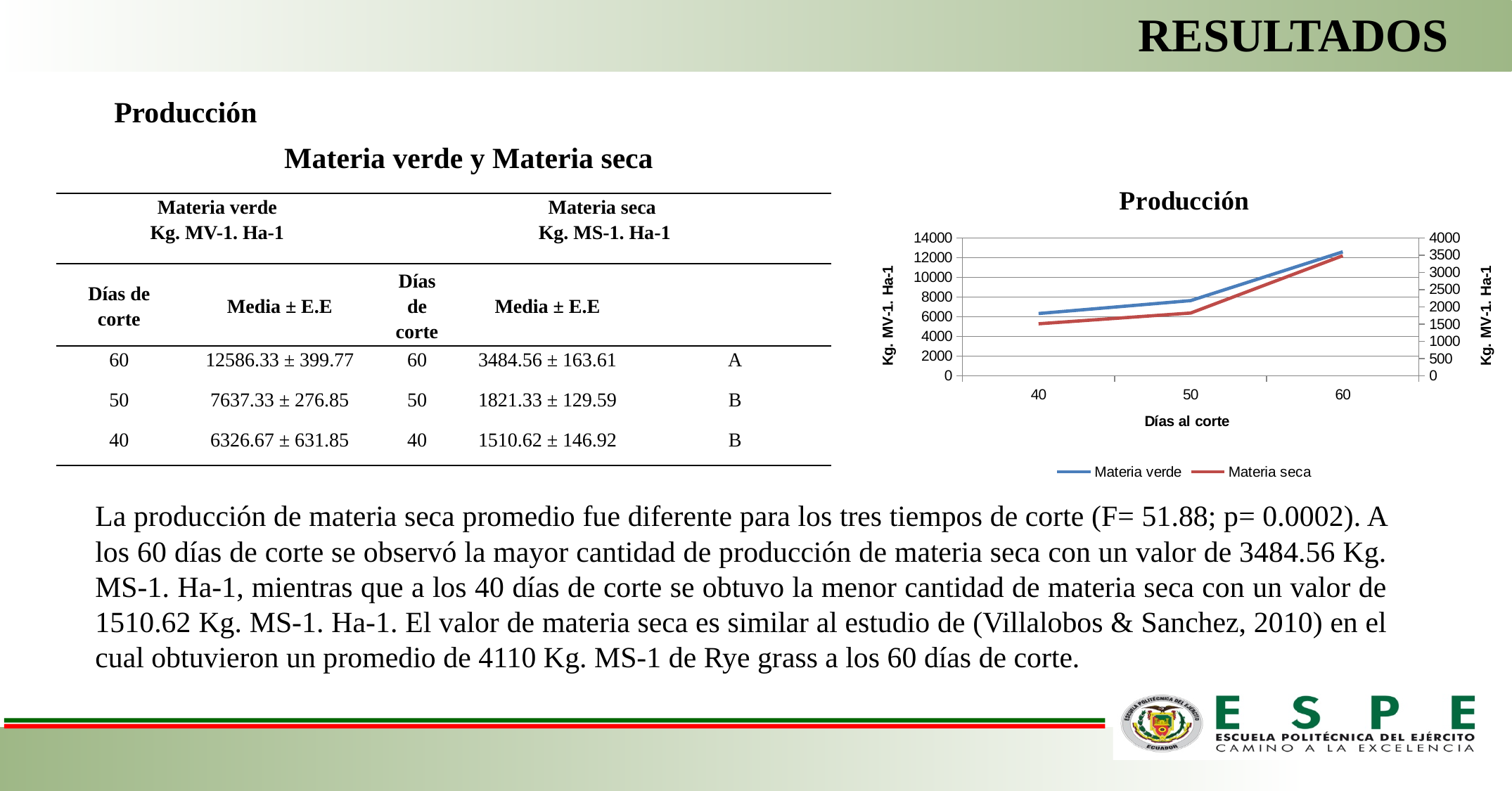
At which Días al corte value is the Materia verde line highest? 60 Is the Materia verde value at 40 días al corte greater or less than 8000? less How many series does the chart legend list? 2 What kind of chart is shown on the slide? line chart How many points along the x axis does each line in the chart have? 3 Is the Materia seca value at 60 días al corte greater or less than 3000 on the right axis? greater Does the Materia verde line rise or fall as Días al corte increases from 40 to 60? rise Is the Materia seca value at 40 días al corte greater or less than 2000 on the right axis? less What is the x-axis title of the chart? Días al corte Does the Materia seca line rise or fall as Días al corte increases from 40 to 60? rise What is the title of the chart on the slide? Producción